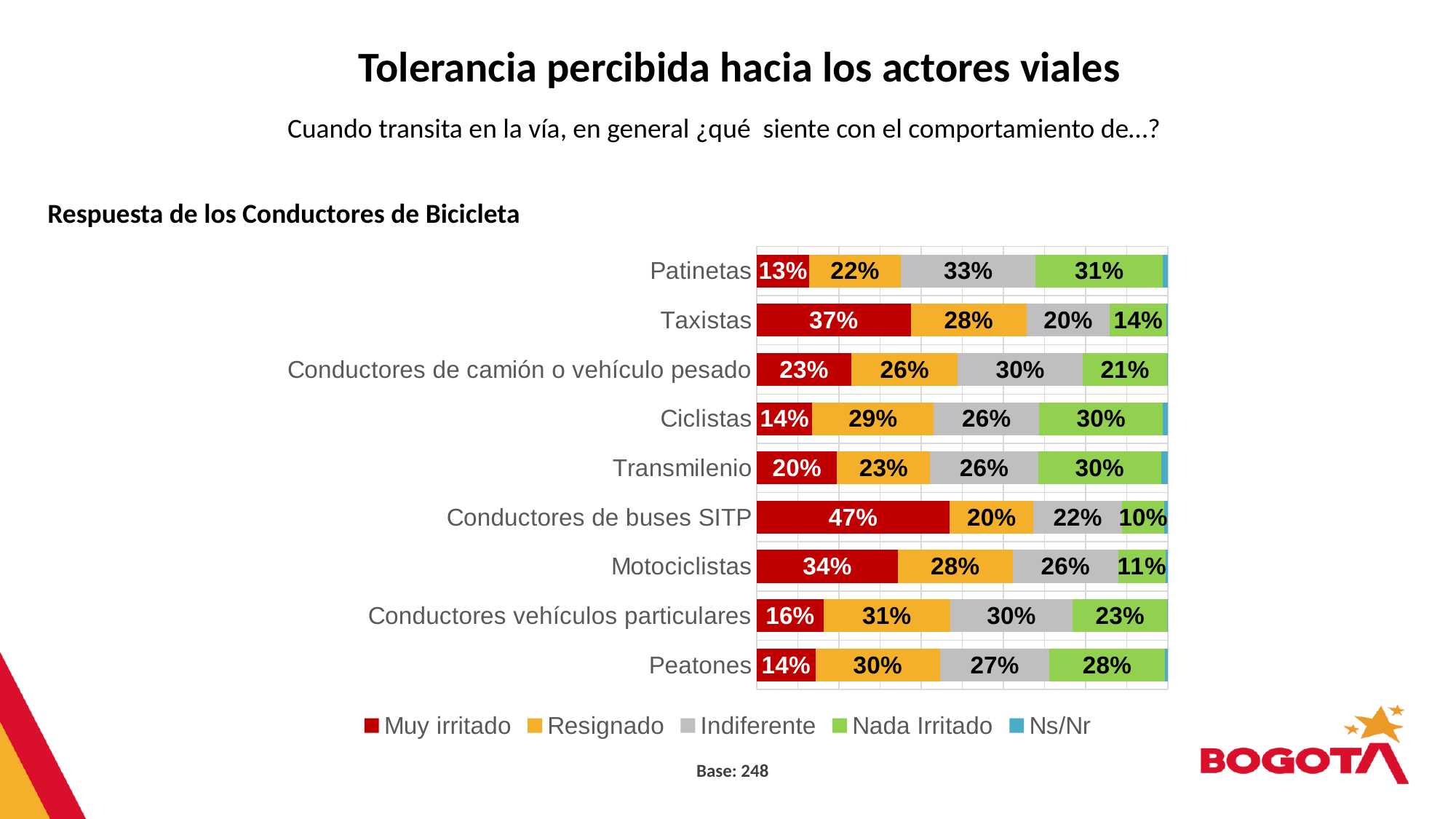
Which has a larger 'Muy irritado' value: Motociclistas or Conductores de camión o vehículo pesado? Motociclistas What percentage of bicycle riders said they feel 'Muy irritado' with the behaviour of Taxistas? 37% What kind of chart is shown on the slide? Stacked bar chart What is the 'Indiferente' value for Patinetas? 33% How many road actor categories are shown in the chart? 9 What is the 'Resignado' value for Peatones? 30% Which road actor has the highest 'Muy irritado' percentage? Conductores de buses SITP Which road actor has the highest 'Indiferente' percentage? Patinetas What is the difference in percentage points between the 'Muy irritado' values for Taxistas and Patinetas? 24 What is the 'Nada Irritado' value for Conductores de buses SITP? 10% How many series does the legend list? 5 Which road actor has the lowest 'Muy irritado' percentage? Patinetas